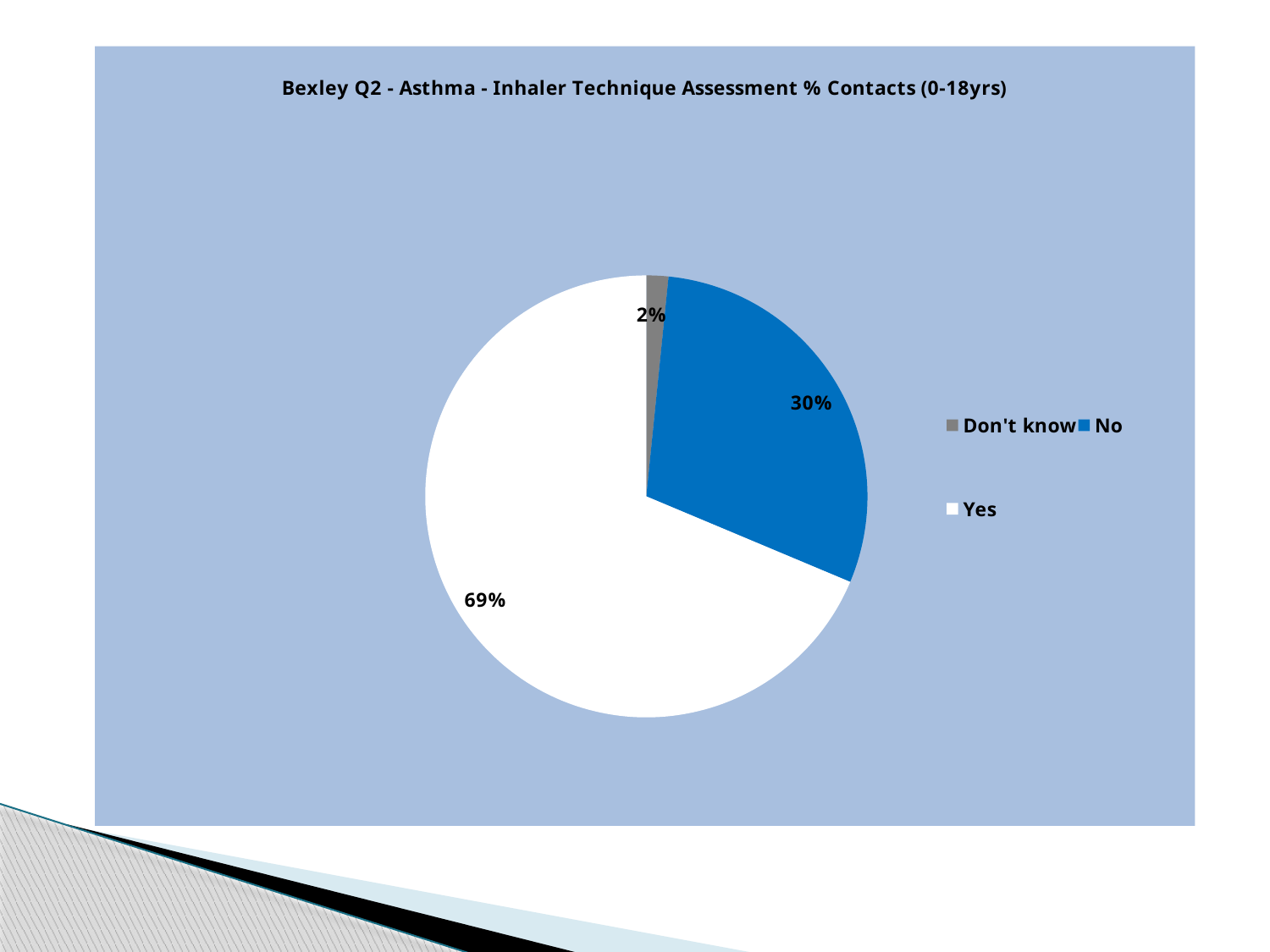
How many slices does the pie chart have? 3 What percentage of contacts is shown for the 'Yes' slice? 69% What colour is the 'No' slice in the pie chart? Blue What is the title of the chart? Bexley Q2 - Asthma - Inhaler Technique Assessment % Contacts (0-18yrs) How many entries does the legend list? 3 What percentage of contacts is shown for the 'Don't know' slice? 2% What kind of chart is shown on the slide? Pie chart Which category has the smallest share of the pie? Don't know Which category has the largest share of the pie? Yes What percentage of contacts is shown for the 'No' slice? 30% Which is larger, the 'No' slice or the 'Don't know' slice? No What is the difference in percentage points between the 'Yes' and 'No' slices? 39